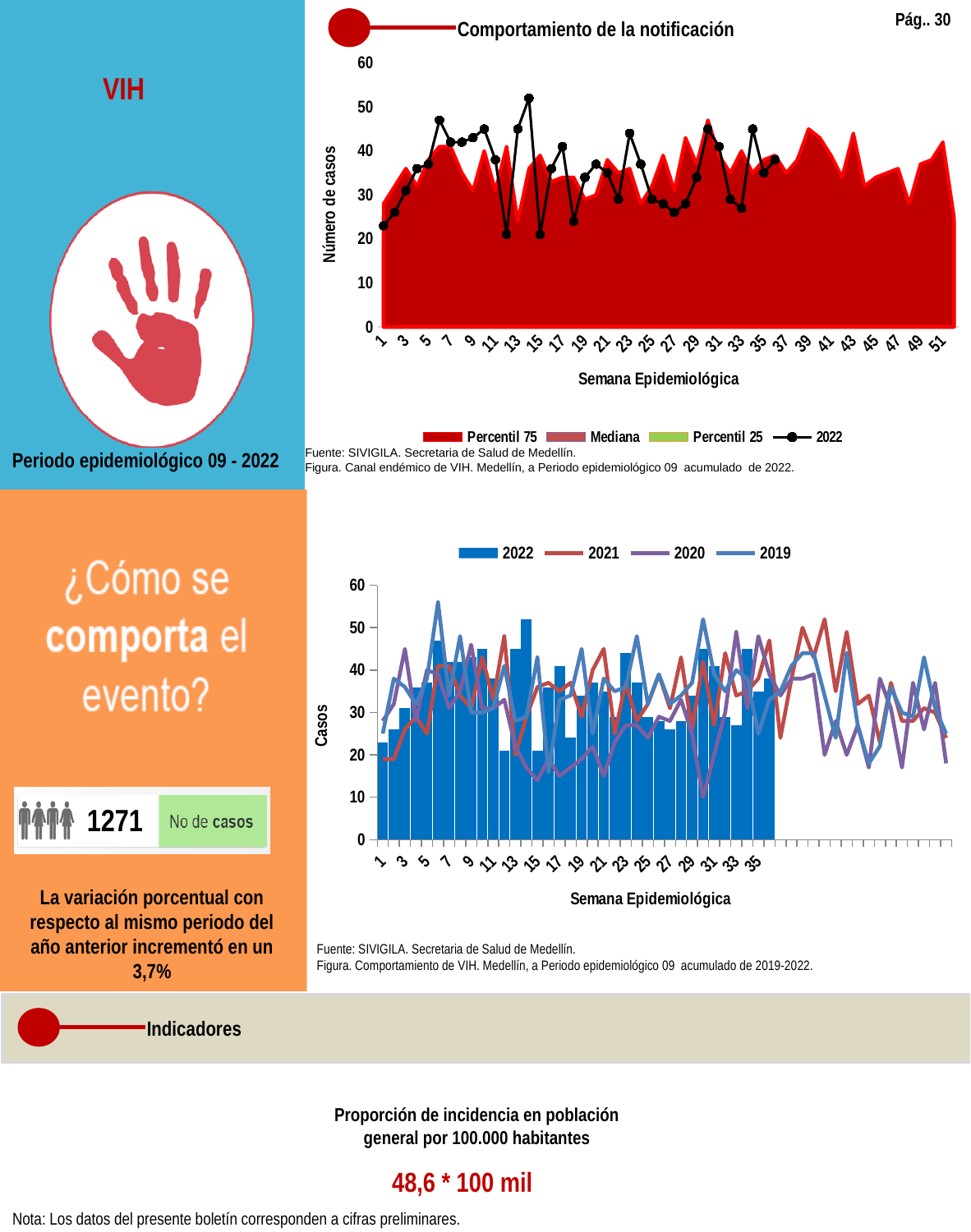
In the top chart 'Comportamiento de la notificación', what is the label of the y axis? Número de casos In the top chart 'Comportamiento de la notificación', is the 2022 value at week 1 greater or less than 30? less In the bottom chart, is the 2022 bar at week 10 greater or less than 40? greater In the top chart 'Comportamiento de la notificación', at which epidemiological week does the 2022 line reach its highest value? 14 In the top chart 'Comportamiento de la notificación', how many series does the legend list? 4 In the top chart 'Comportamiento de la notificación', what are the legend entries? Percentil 75, Mediana, Percentil 25, 2022 In the bottom chart, at which epidemiological week is the 2022 bar the tallest? 14 In the top chart 'Comportamiento de la notificación', is the 2022 value at week 12 greater or less than 30? less In the bottom chart, how many series does the legend list? 4 In the bottom chart, which series is drawn as bars? 2022